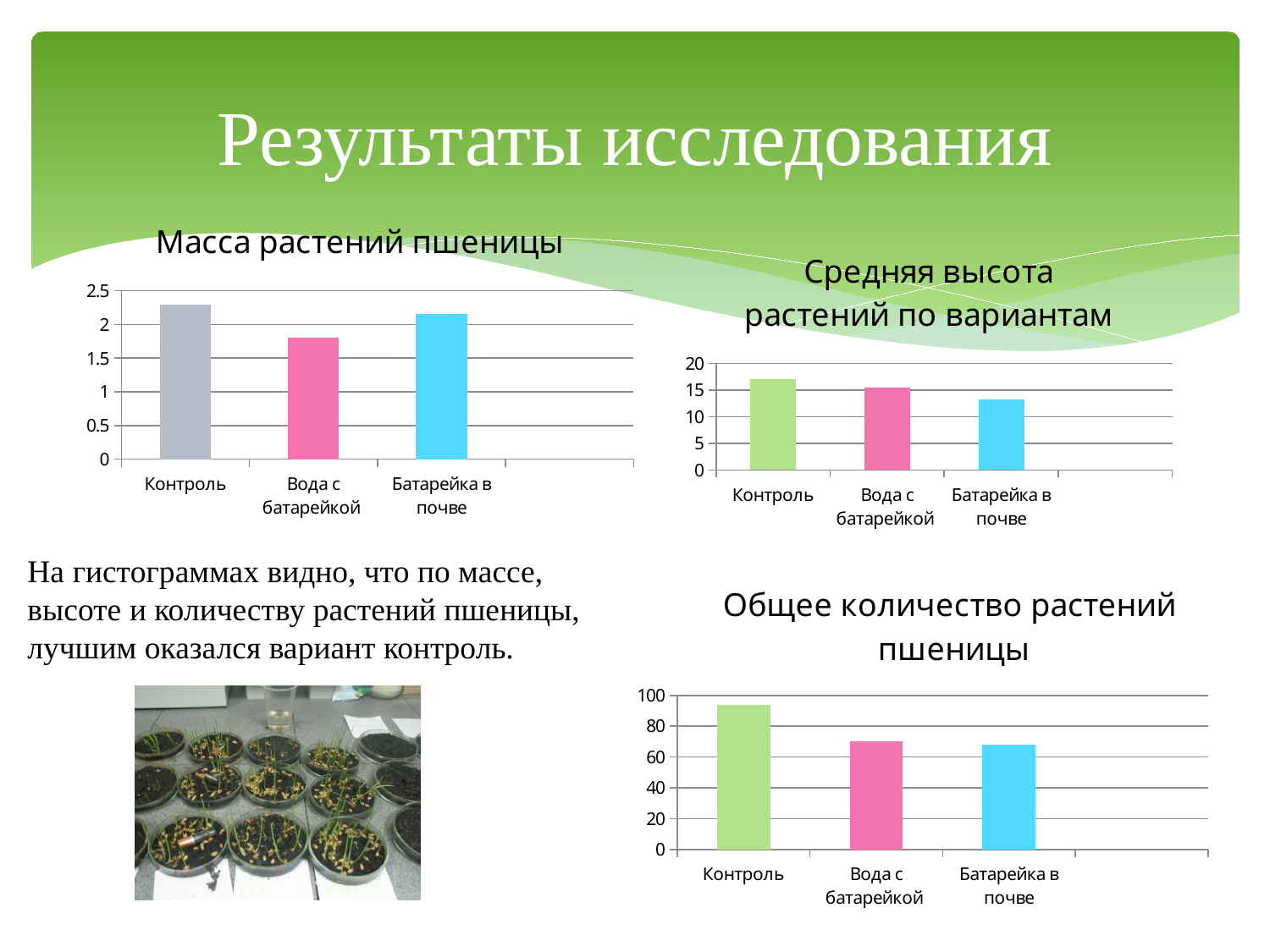
In the chart titled "Общее количество растений пшеницы", which category has the highest value? Контроль How many categories are shown in the chart titled "Общее количество растений пшеницы"? 3 What kind of chart is the one titled "Масса растений пшеницы"? bar chart In the chart titled "Общее количество растений пшеницы", is the value for Контроль greater or less than 80? greater In the chart titled "Масса растений пшеницы", which category has the lowest value? Вода с батарейкой In the chart titled "Масса растений пшеницы", is the value for Батарейка в почве greater or less than 2? greater In the chart titled "Масса растений пшеницы", which category has the highest value? Контроль In the chart titled "Общее количество растений пшеницы", is the value for Батарейка в почве greater or less than 80? less In the chart titled "Средняя высота растений по вариантам", which is larger: Контроль or Вода с батарейкой? Контроль In the chart titled "Средняя высота растений по вариантам", which category has the lowest value? Батарейка в почве